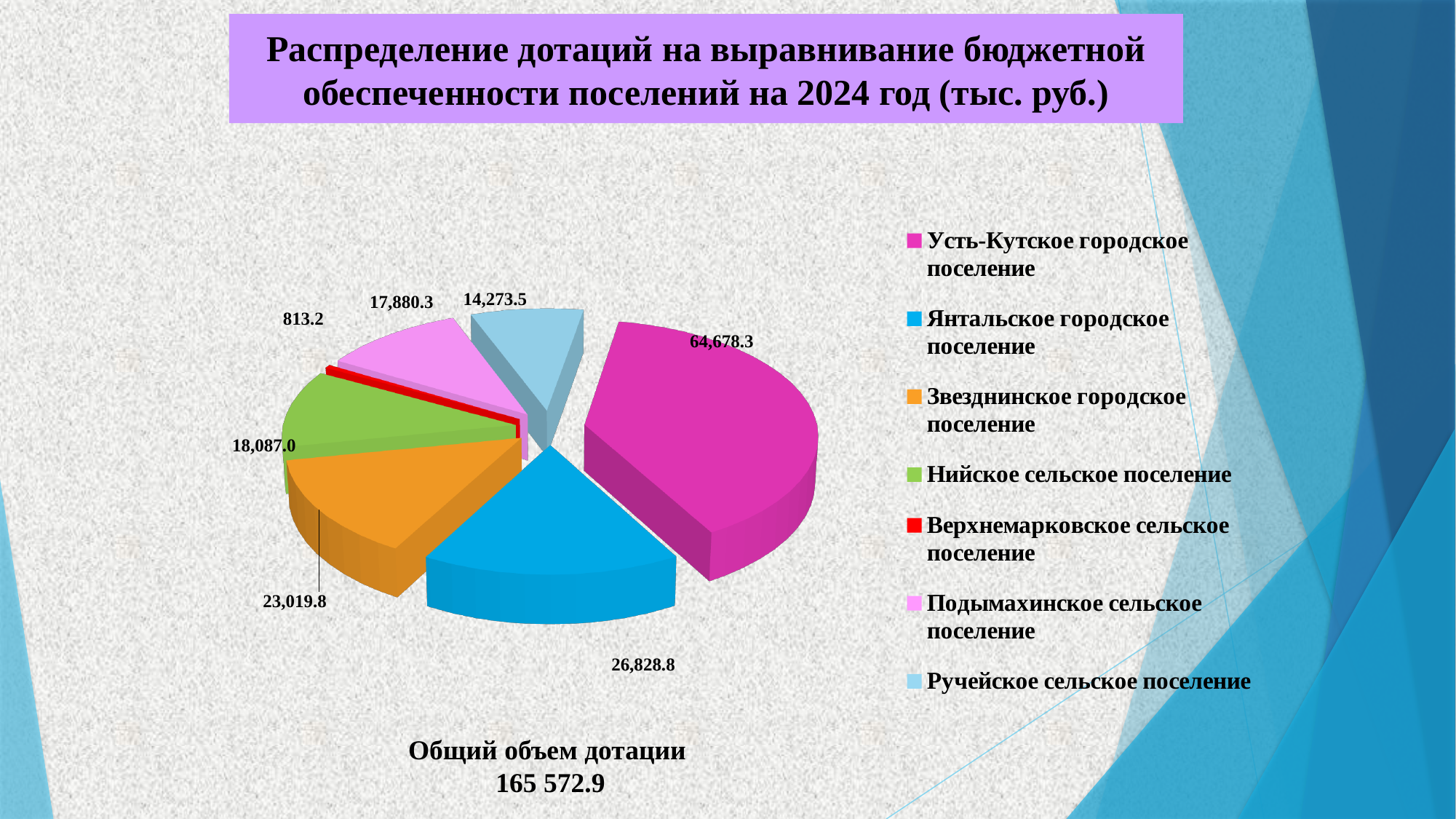
How many settlements are shown in the pie chart? 7 What type of chart is shown on the slide? pie chart What is the difference between the values for Звезднинское городское поселение and Нийское сельское поселение? 4,932.8 Which is larger, the value for Звезднинское городское поселение or the value for Ручейское сельское поселение? Звезднинское городское поселение Which settlement receives the smallest share of the subsidy? Верхнемарковское сельское поселение What is the value for Усть-Кутское городское поселение? 64,678.3 What is the value for Ручейское сельское поселение? 14,273.5 Which settlement receives the largest share of the subsidy? Усть-Кутское городское поселение What is the value for Янтальское городское поселение? 26,828.8 What is the value for Верхнемарковское сельское поселение? 813.2 What is the difference between the values for Усть-Кутское городское поселение and Янтальское городское поселение? 37,849.5 What total subsidy volume is stated below the chart? 165 572.9